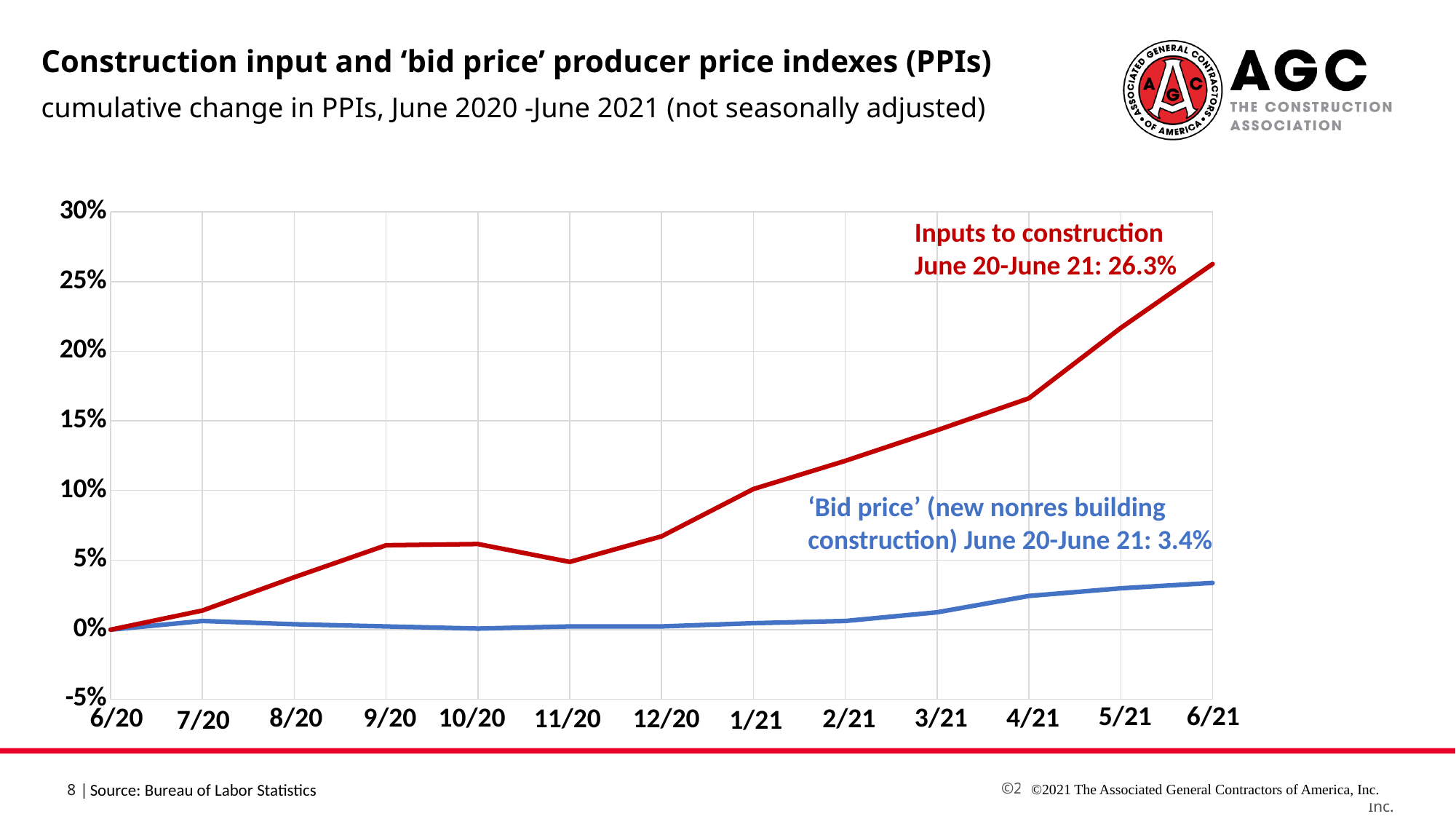
How many data series are plotted on the chart? 2 Is the value for Inputs to construction at 12/20 greater or less than 10%? less Does the Inputs to construction line rise or fall overall from 6/20 to 6/21? rise How many monthly points are shown on the x axis? 13 Which series shows the larger cumulative change at 6/21, Inputs to construction or 'Bid price'? Inputs to construction How much larger is the June 20-June 21 cumulative change for Inputs to construction than for 'Bid price'? 22.9 percentage points Is the value for Inputs to construction at 4/21 greater or less than 15%? greater What is the cumulative change in the 'Bid price' (new nonres building construction) PPI from June 2020 to June 2021? 3.4% What kind of chart is shown on the slide? line chart What is the cumulative change in the Inputs to construction PPI from June 2020 to June 2021? 26.3% Is the value for Inputs to construction at 5/21 greater or less than 20%? greater